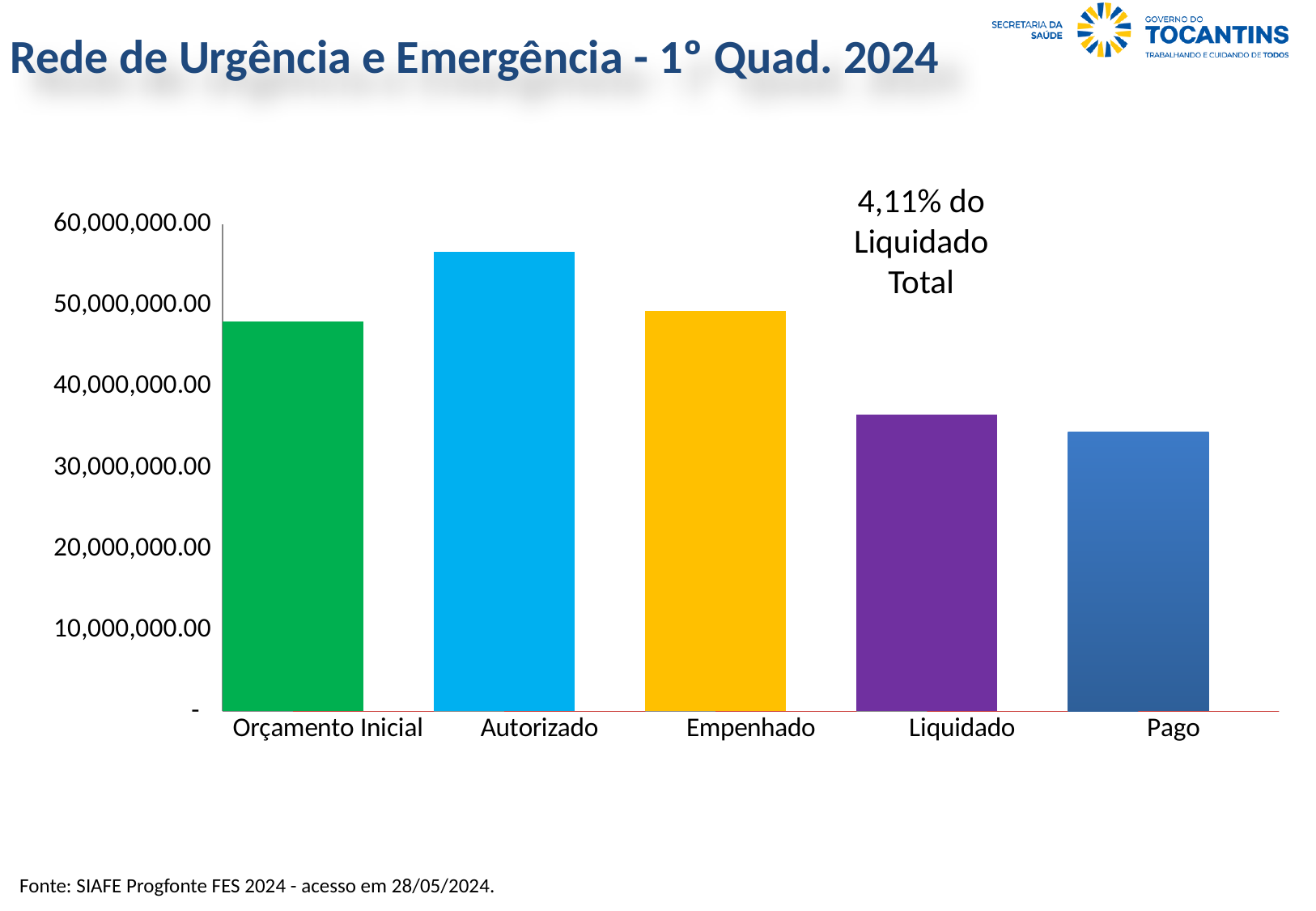
Is the value for Autorizado greater or less than 50,000,000.00? greater Which is larger, the value for Autorizado or the value for Empenhado? Autorizado What is the title of the slide containing the chart? Rede de Urgência e Emergência - 1° Quad. 2024 Is the value for Pago greater or less than 30,000,000.00? greater Which category has the lowest bar? Pago What kind of chart is shown on the slide? bar chart Which is larger, the value for Liquidado or the value for Pago? Liquidado What percentage is stated in the annotation above the Liquidado bar? 4,11% How many categories are shown on the x axis of the chart? 5 Is the value for Orçamento Inicial greater or less than 50,000,000.00? less Which category has the highest bar? Autorizado